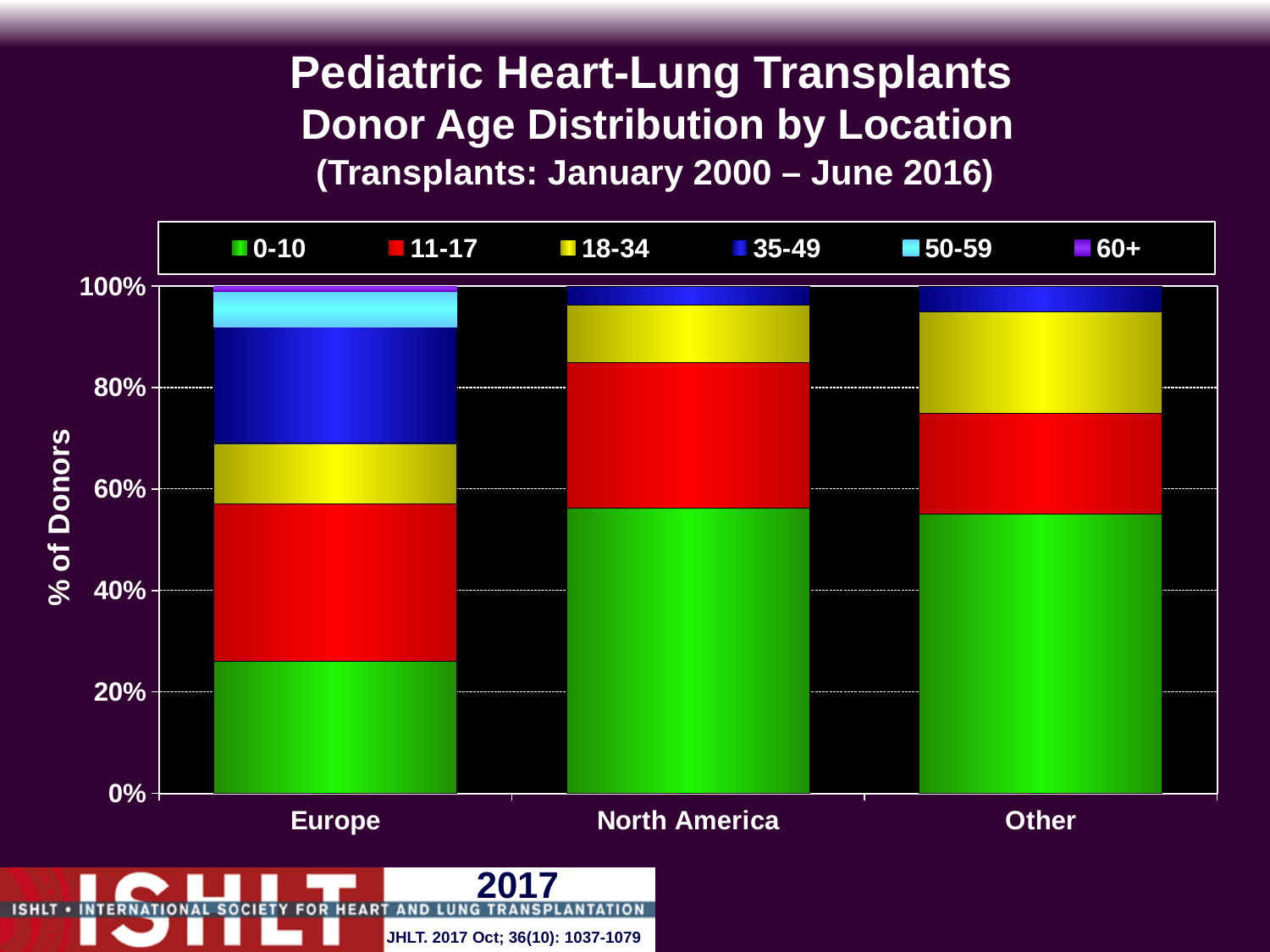
Which location has the largest share of 18-34 donors? Other How many donor age groups does the legend list? 6 Is the share of 18-34 donors in Other greater or less than 10%? greater Is the share of 0-10 donors in Europe greater or less than 20%? greater Which has the larger share of 0-10 donors, Europe or North America? North America Which has the larger share of 11-17 donors, Europe or Other? Europe How many locations are shown on the x axis? 3 Which location has the smallest share of 0-10 donors? Europe What is the label of the y axis? % of Donors What kind of chart is shown on the slide? Stacked bar chart Is the share of 0-10 donors in North America greater or less than 40%? greater Which location has the largest share of 35-49 donors? Europe